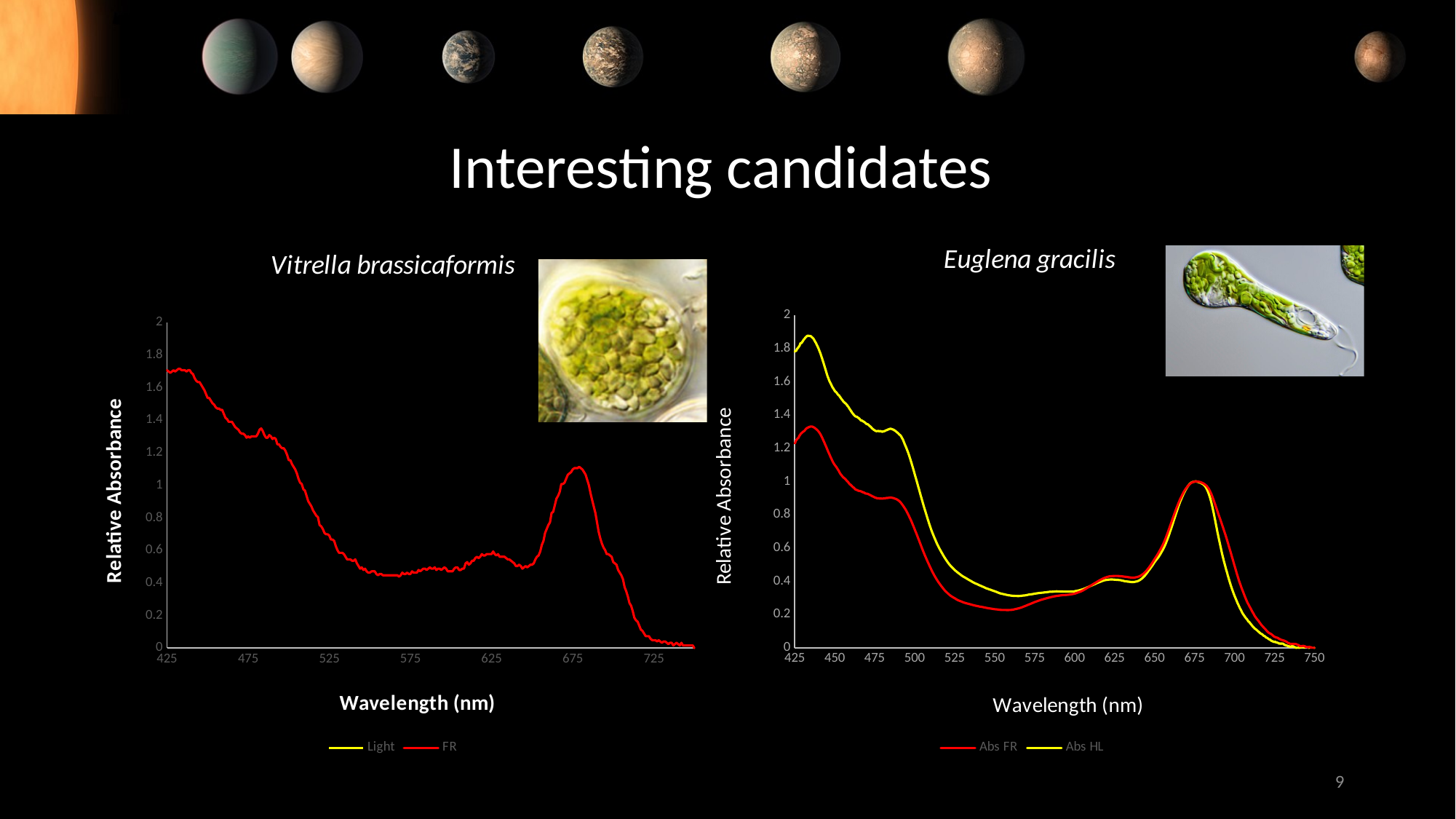
How many series does the legend of the Euglena gracilis chart list? 2 What is the x-axis title of the Euglena gracilis chart? Wavelength (nm) In the Vitrella brassicaformis chart, is the FR peak near 675 nm greater or less than 0.8? greater In the Euglena gracilis chart, which series is higher at 700 nm, Abs FR or Abs HL? Abs FR In the Vitrella brassicaformis chart, is the FR value at 575 nm greater or less than 0.6? less In the Euglena gracilis chart, is the Abs HL value at 425 nm greater or less than 1.6? greater In the Euglena gracilis chart, which series is higher at 425 nm, Abs FR or Abs HL? Abs HL In the Vitrella brassicaformis chart, does the FR line rise or fall between 425 nm and 575 nm? fall How many series does the legend of the Vitrella brassicaformis chart list? 2 What kind of chart is the Vitrella brassicaformis chart on the left? line chart